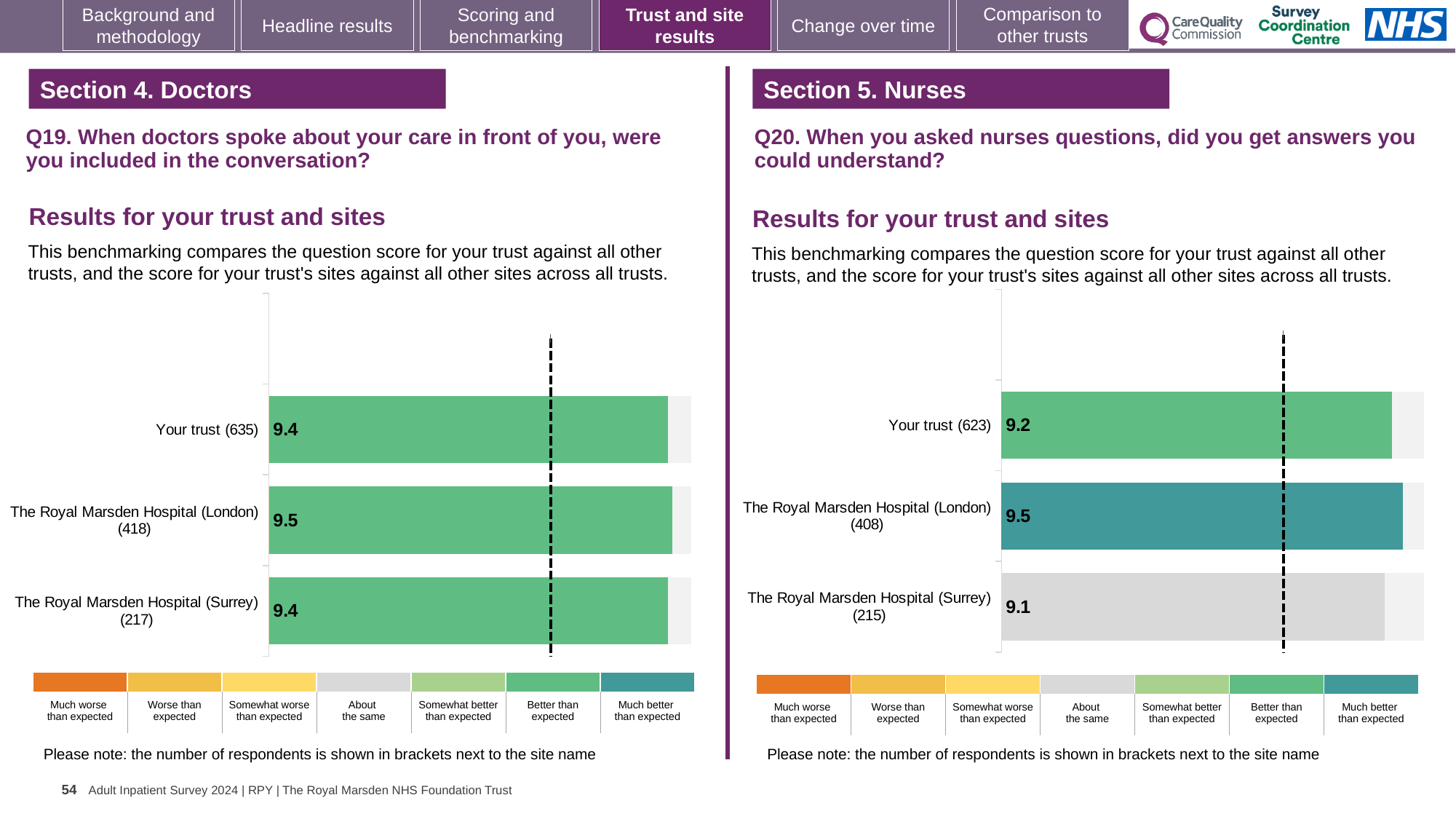
What type of chart is used for the Q20 results on the right? Bar chart How many bars are shown in the Q19 chart on the left? 3 In the Q20 chart on the right, which site or trust has the lowest score? The Royal Marsden Hospital (Surrey) (215) In the Q20 chart on the right, which benchmarking category does the colour of the bar for The Royal Marsden Hospital (Surrey) (215) indicate? About the same In the Q19 chart on the left, what is the difference between the scores for The Royal Marsden Hospital (London) and Your trust? 0.1 In the Q20 chart on the right, which has the larger score: Your trust or The Royal Marsden Hospital (Surrey)? Your trust In the Q20 chart on the right, what is the score for The Royal Marsden Hospital (Surrey) (215)? 9.1 In the Q20 chart on the right, what is the difference between the scores for The Royal Marsden Hospital (London) and The Royal Marsden Hospital (Surrey)? 0.4 In the Q19 chart on the left, what is the score for The Royal Marsden Hospital (London) (418)? 9.5 In the Q19 chart on the left, what is the score for Your trust (635)? 9.4 In the Q20 chart on the right, what is the score for Your trust (623)? 9.2 In the Q20 chart on the right, which site or trust has the highest score? The Royal Marsden Hospital (London) (408)